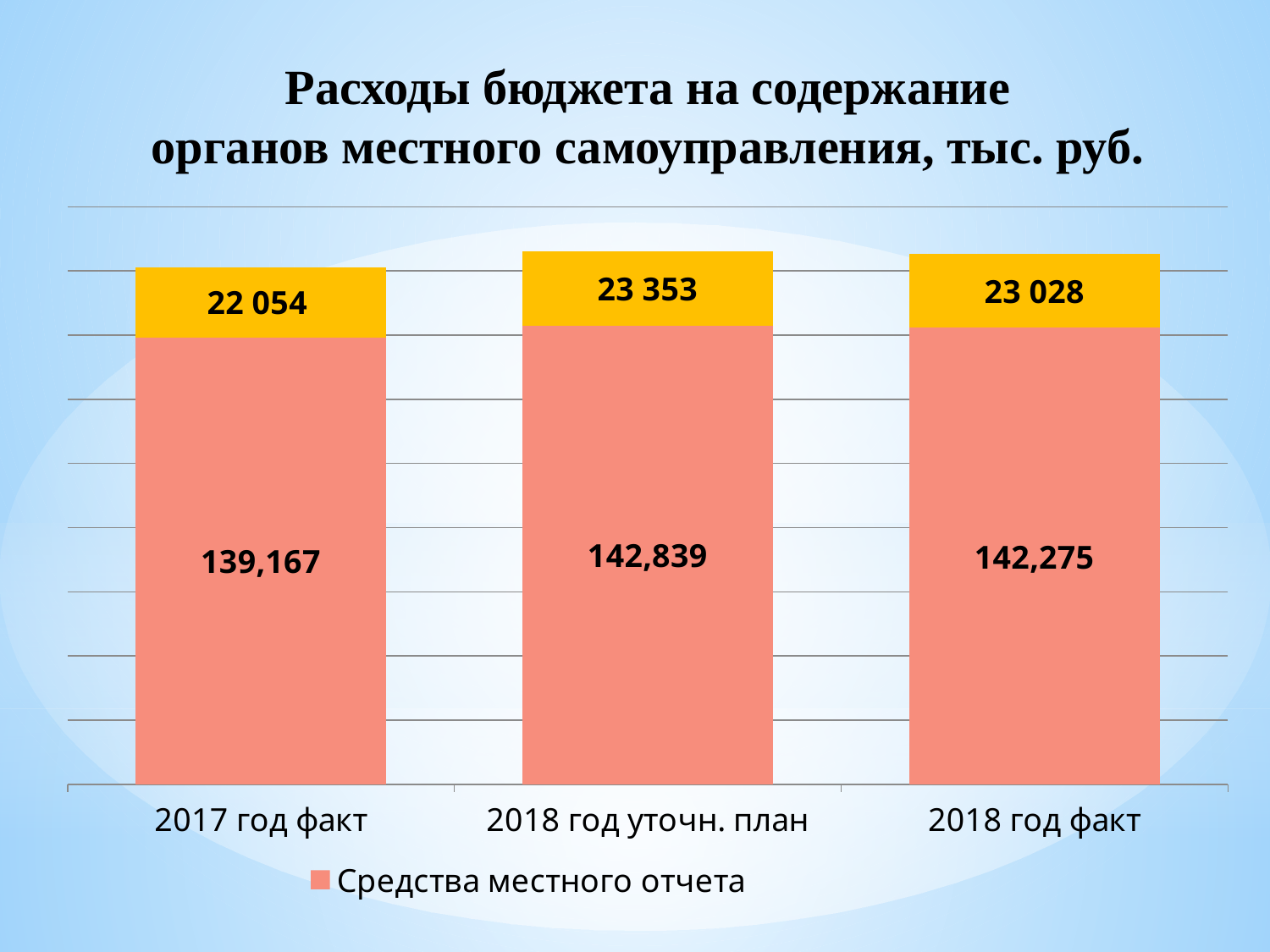
What is the value of Средства местного отчета for 2018 год уточн. план? 142,839 How many categories are shown on the x axis? 3 What is the value of the yellow (top) segment for 2018 год уточн. план? 23 353 What type of chart is shown on the slide? Stacked bar chart What is the value of the yellow (top) segment for 2017 год факт? 22 054 What is the difference between the Средства местного отчета values for 2018 год уточн. план and 2017 год факт? 3,672 Which category has the lowest value of Средства местного отчета? 2017 год факт Which category has the highest value of Средства местного отчета? 2018 год уточн. план What is the difference between the yellow segment values for 2018 год уточн. план and 2018 год факт? 325 What is the value of Средства местного отчета for 2017 год факт? 139,167 What is the value of Средства местного отчета for 2018 год факт? 142,275 How many series does the legend list? 1